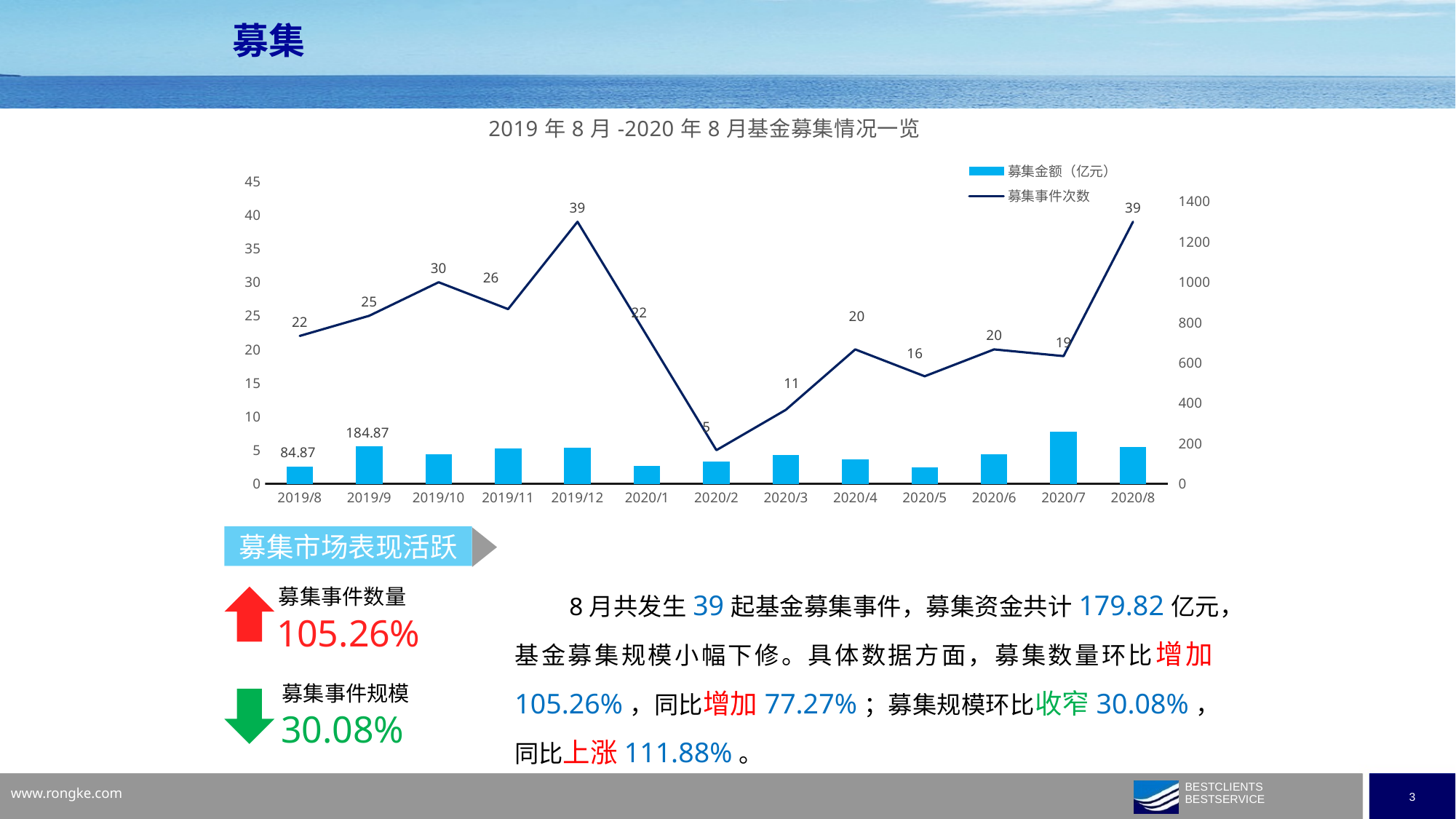
Is the 募集金额（亿元） bar for 2020/7 greater or less than 200 on the right axis? greater What is the difference in 募集金额（亿元） between 2019/9 and 2019/8? 100 What kind of chart is this? Combined bar and line chart Which month has a higher 募集事件次数, 2020/4 or 2020/5? 2020/4 What is the 募集金额（亿元） value for 2019/9? 184.87 How many series does the legend list? 2 What is the 募集事件次数 value for 2020/2? 5 Which month has the lowest 募集事件次数? 2020/2 Which months share the highest 募集事件次数 value? 2019/12 and 2020/8 How many months are shown on the x axis? 13 What is the difference in 募集事件次数 between 2019/12 and 2020/1? 17 What is the 募集事件次数 value for 2019/12? 39